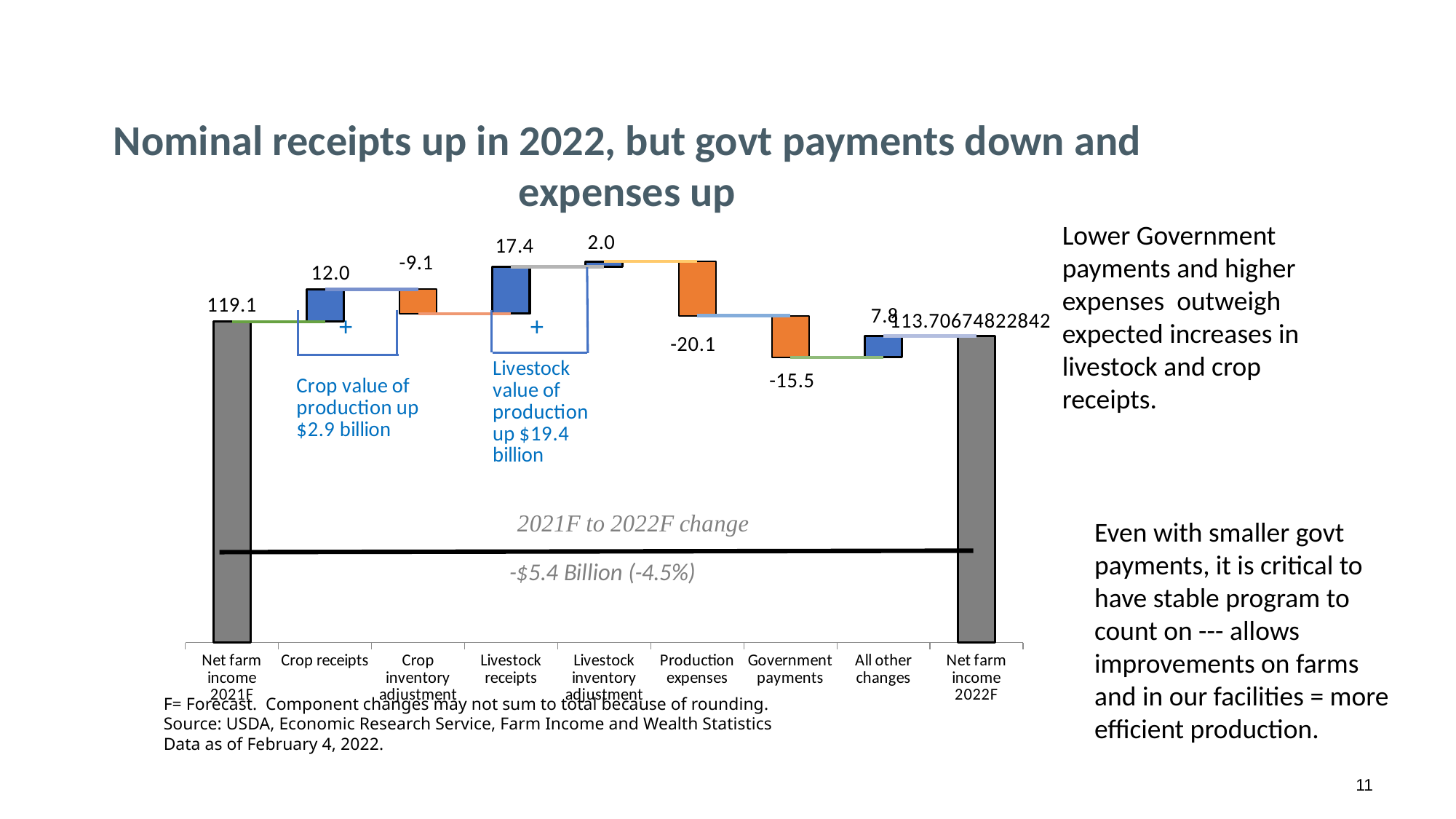
What is the value shown for Production expenses? -20.1 Which component shows the largest negative change in the chart? Production expenses What is the difference between the value for Livestock receipts and the value for Crop receipts? 5.4 How many categories are shown along the x axis of the chart? 9 Which is larger, the value for Livestock receipts or the value for Crop receipts? Livestock receipts What is the value shown for Government payments? -15.5 What is the value shown for Livestock receipts? 17.4 What is the value shown for Net farm income 2021F? 119.1 What is the value shown for Crop inventory adjustment? -9.1 What is the value shown for Crop receipts? 12.0 What kind of chart is shown on the slide? bar chart What is the value shown for Livestock inventory adjustment? 2.0